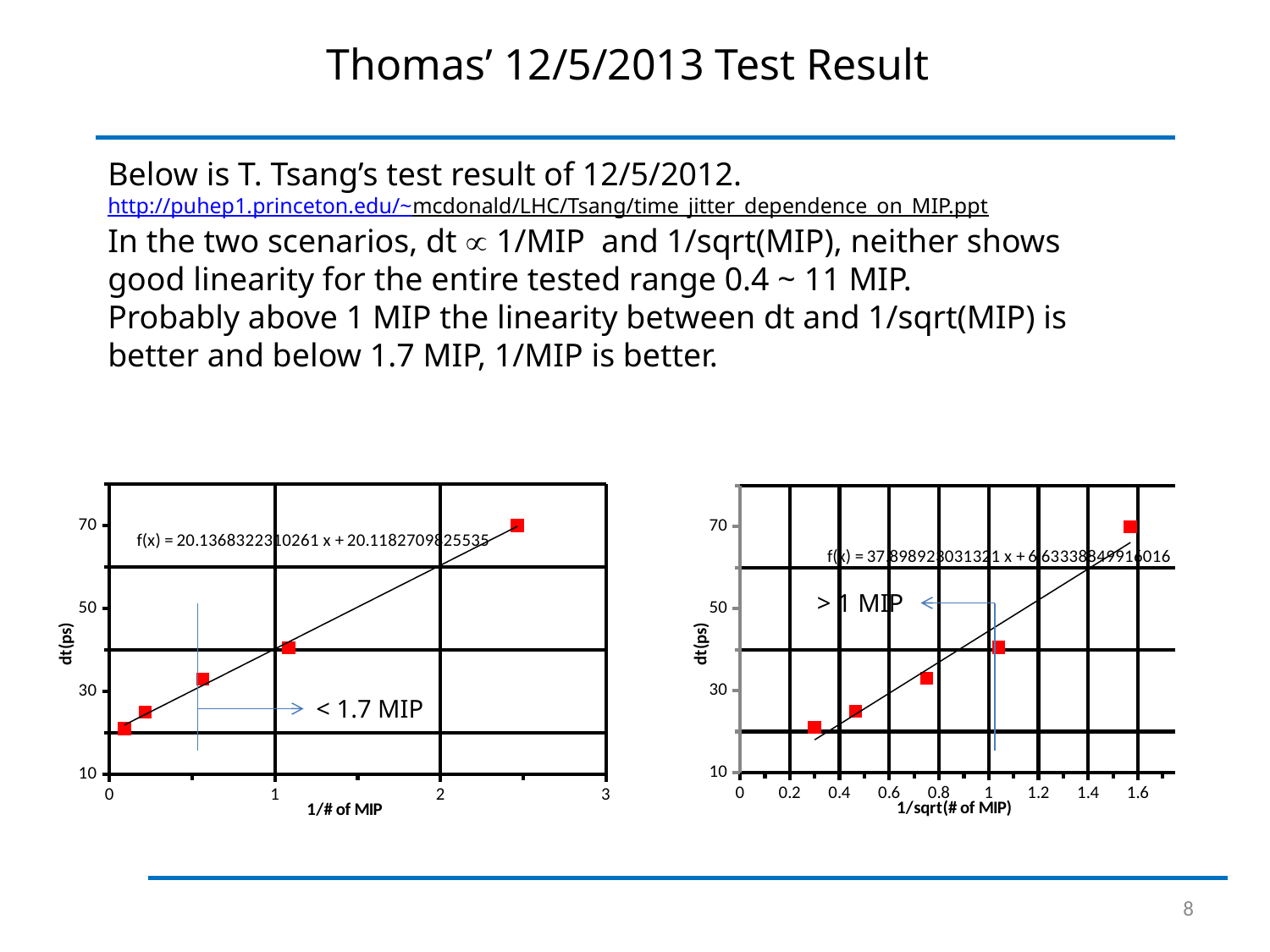
How many data points are plotted on the right chart (1/sqrt(# of MIP))? 5 How many data points are plotted on the left chart (1/# of MIP)? 5 On the right chart (1/sqrt(# of MIP)), is the dt(ps) value of the leftmost data point greater or less than 30? less What kind of chart is the left chart with x-axis '1/# of MIP'? scatter chart On the right chart (1/sqrt(# of MIP)), is the dt(ps) value of the rightmost data point greater or less than 50? greater On the left chart (1/# of MIP), is the dt(ps) value of the rightmost data point greater or less than 50? greater What kind of chart is the right chart with x-axis '1/sqrt(# of MIP)'? scatter chart On the left chart (1/# of MIP), do the dt(ps) values rise or fall as 1/# of MIP increases? rise On the right chart (1/sqrt(# of MIP)), do the dt(ps) values rise or fall as 1/sqrt(# of MIP) increases? rise What is the x-axis label on the right chart? 1/sqrt(# of MIP) What is the y-axis label on the left chart? dt(ps)